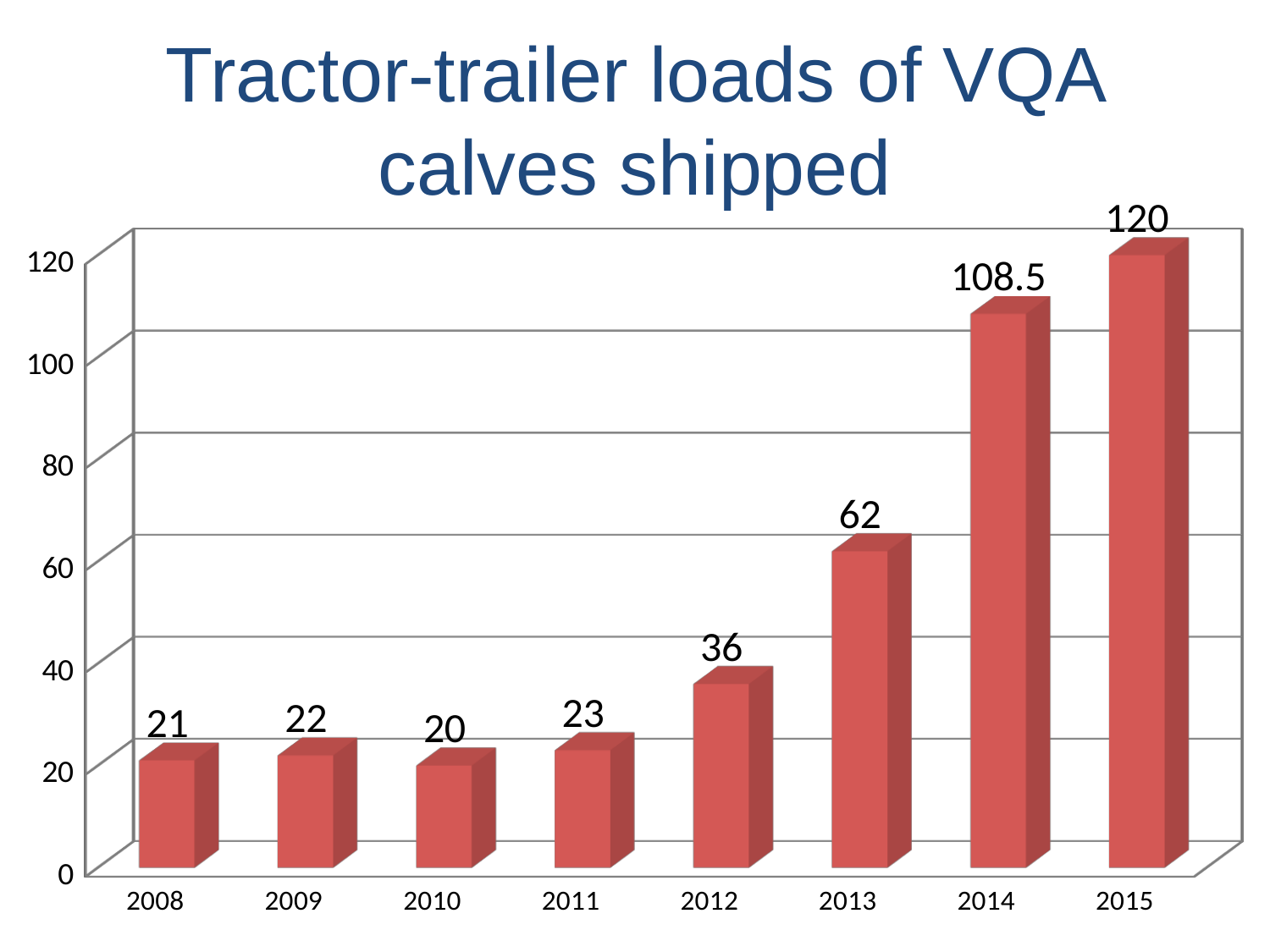
What is the difference between the values for 2013 and 2012? 26 How many years are shown on the x axis? 8 Which year has the lowest value? 2010 What is the value for 2010? 20 What is the difference between the values for 2015 and 2014? 11.5 Which is larger, the value for 2013 or the value for 2012? 2013 What is the value for 2014? 108.5 What is the title of the chart? Tractor-trailer loads of VQA calves shipped Is the value for 2013 greater or less than 80? less What is the value for 2012? 36 What kind of chart is shown on the slide? bar chart Which year has the highest value? 2015